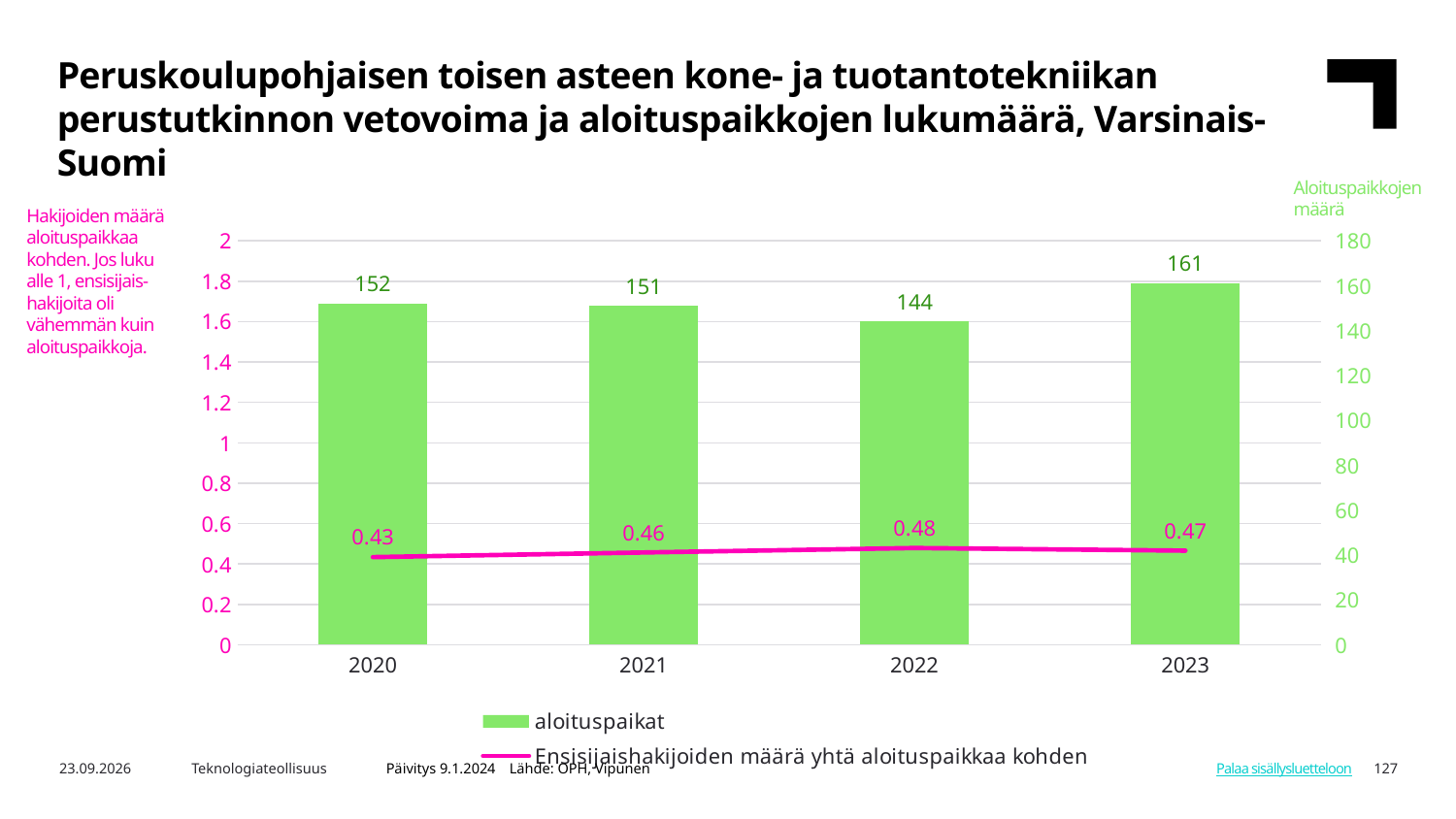
What is the difference in aloituspaikat between 2023 and 2022? 17 Which year has the highest value of aloituspaikat? 2023 What is the value of aloituspaikat for 2020? 152 How many years are shown on the x axis? 4 What is the value of Ensisijaishakijoiden määrä yhtä aloituspaikkaa kohden for 2022? 0.48 What is the value of Ensisijaishakijoiden määrä yhtä aloituspaikkaa kohden for 2020? 0.43 Which year has a larger value of aloituspaikat, 2020 or 2022? 2020 What is the value of aloituspaikat for 2023? 161 What colour are the aloituspaikat bars? green How many series does the legend list? 2 Which year has the lowest value of aloituspaikat? 2022 What kind of chart is used to show aloituspaikat? bar chart